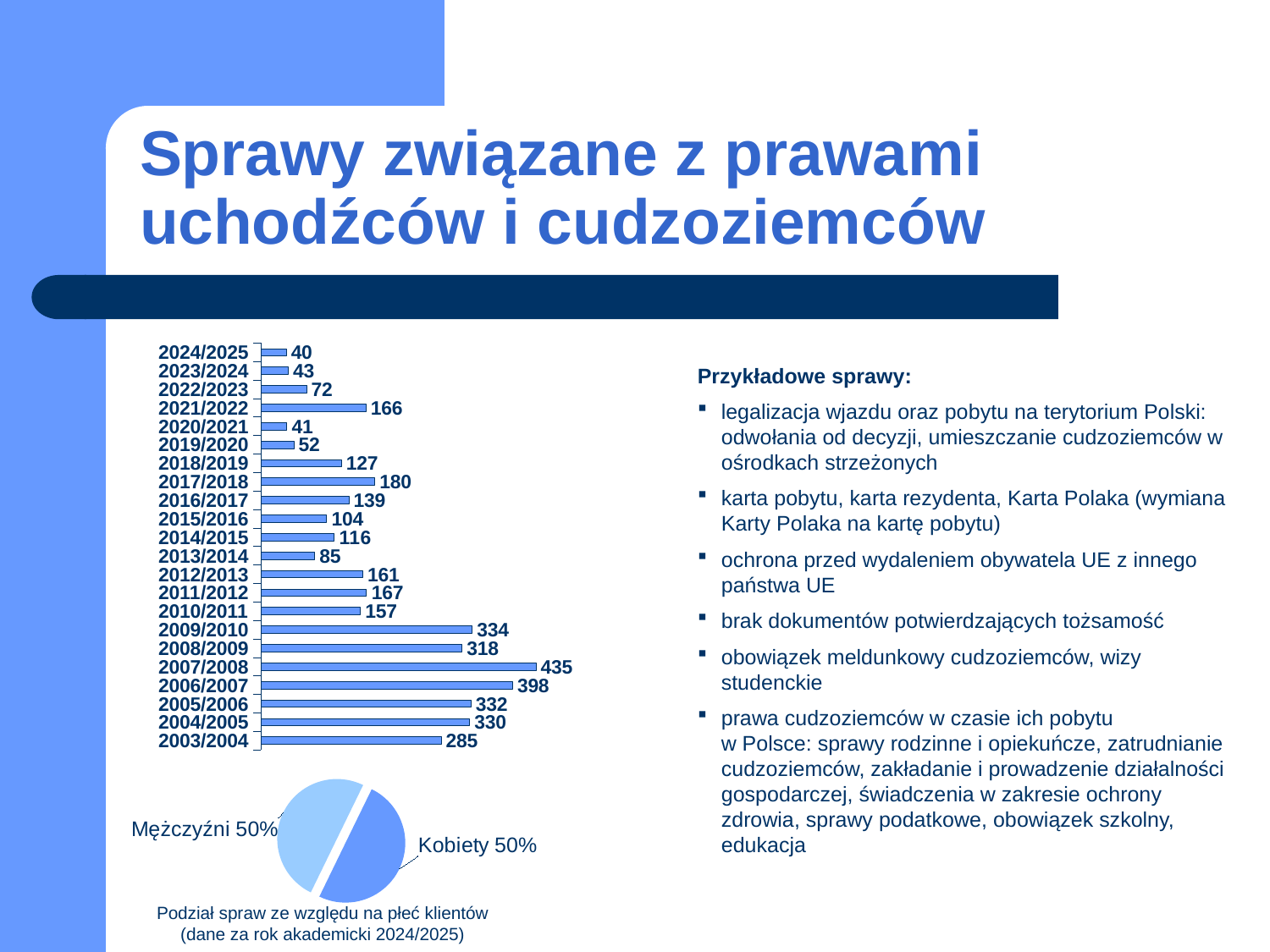
In the bar chart on the left of the slide, which is larger: the value for 2021/2022 or the value for 2022/2023? 2021/2022 In the bar chart on the left of the slide, which academic year has the lowest value? 2024/2025 In the bar chart on the left of the slide, what is the value for 2024/2025? 40 In the bar chart on the left of the slide, what is the difference between the values for 2009/2010 and 2008/2009? 16 In the bar chart on the left of the slide, what is the value for 2007/2008? 435 How many academic years are shown in the bar chart on the left of the slide? 22 What is the caption below the pie chart at the bottom left of the slide? Podział spraw ze względu na płeć klientów (dane za rok akademicki 2024/2025) How many slices does the pie chart at the bottom left of the slide have? 2 In the bar chart on the left of the slide, what is the value for 2017/2018? 180 In the bar chart on the left of the slide, which academic year has the highest value? 2007/2008 What kind of chart is the upper chart on the left of the slide? bar chart In the pie chart at the bottom left of the slide, what share is labelled Kobiety? 50%